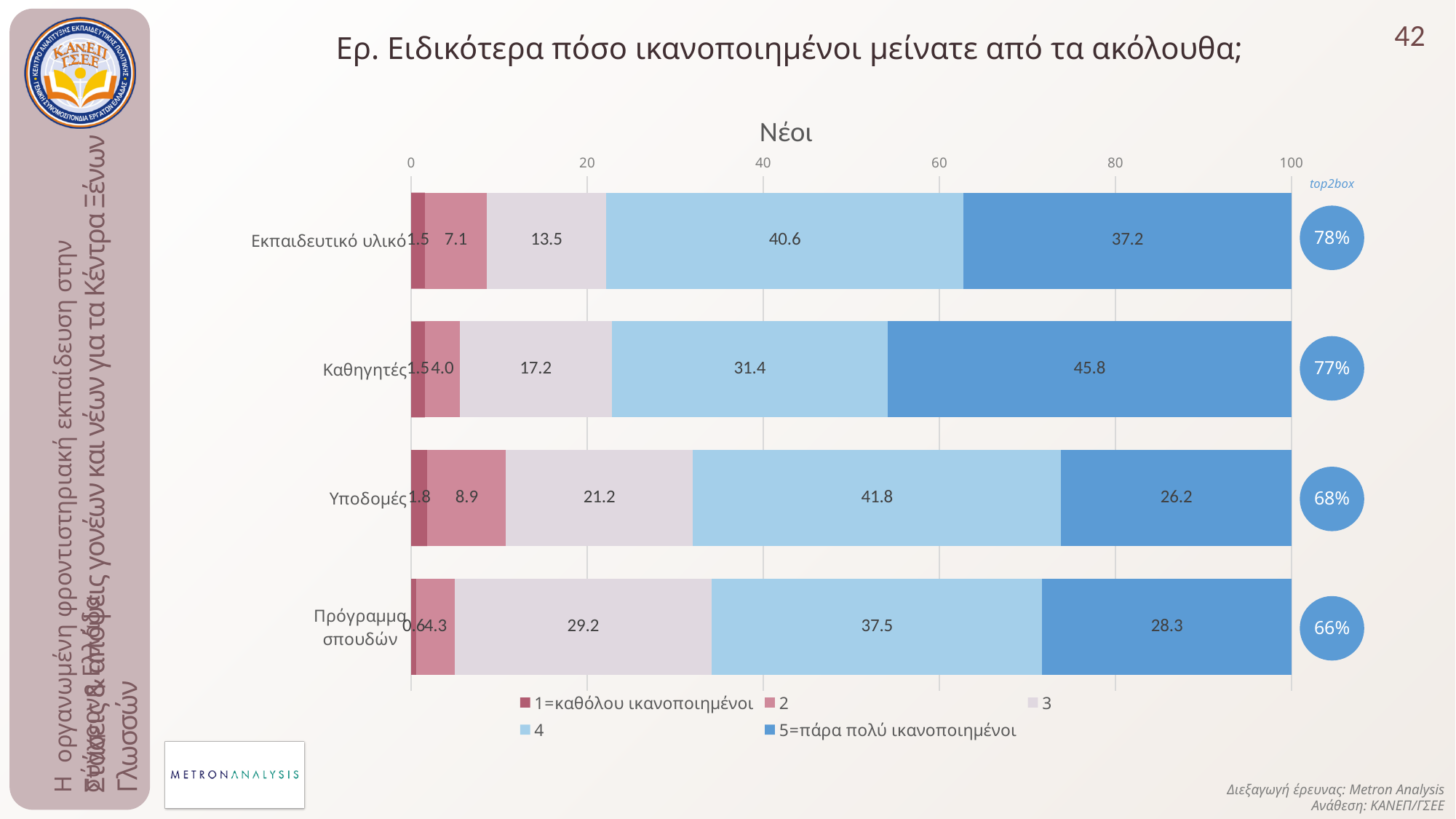
What is the value of series 2 for Υποδομές? 8.9 What is the value of series 4 for Εκπαιδευτικό υλικό? 40.6 Which is larger: the series 4 value for Υποδομές or for Καθηγητές? Υποδομές What is the difference between the series 3 values for Πρόγραμμα σπουδών and Εκπαιδευτικό υλικό? 15.7 How many categories are plotted in the chart? 4 What type of chart is shown on the slide? Stacked bar chart What is the value of series 3 for Πρόγραμμα σπουδών? 29.2 Which category has the lowest value for series 1=καθόλου ικανοποιημένοι? Πρόγραμμα σπουδών Which category has the highest value for series 5=πάρα πολύ ικανοποιημένοι? Καθηγητές How many series does the legend list? 5 What is the top2box percentage shown for Υποδομές? 68% What is the value of series 5=πάρα πολύ ικανοποιημένοι for Καθηγητές? 45.8